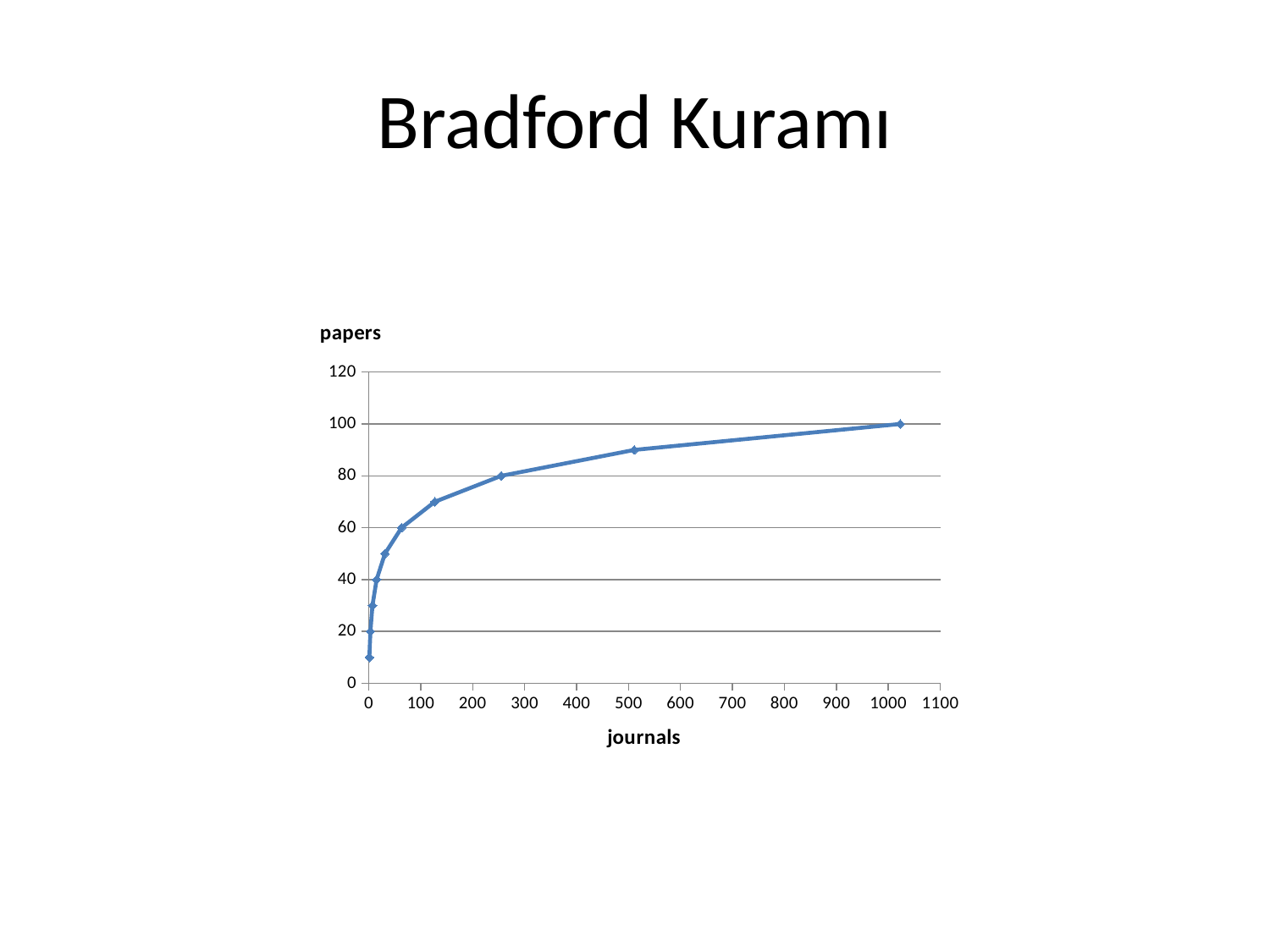
Do the papers values rise or fall as the number of journals increases? rise What is the difference in papers between the rightmost point and the third point from the right? 20 What is the highest papers value reached by the line? 100 What is the label of the vertical axis? papers Is the papers value of the second point from the right greater or less than 80? greater Is the papers value of the rightmost point greater or less than 120? less What is the label of the horizontal axis? journals Is the papers value of the lowest point on the line greater or less than 20? less What is the papers value of the third point from the right? 80 What kind of chart is shown on the slide? line chart What is the papers value of the rightmost point on the line? 100 Which has a higher papers value: the rightmost point or the third point from the right? the rightmost point